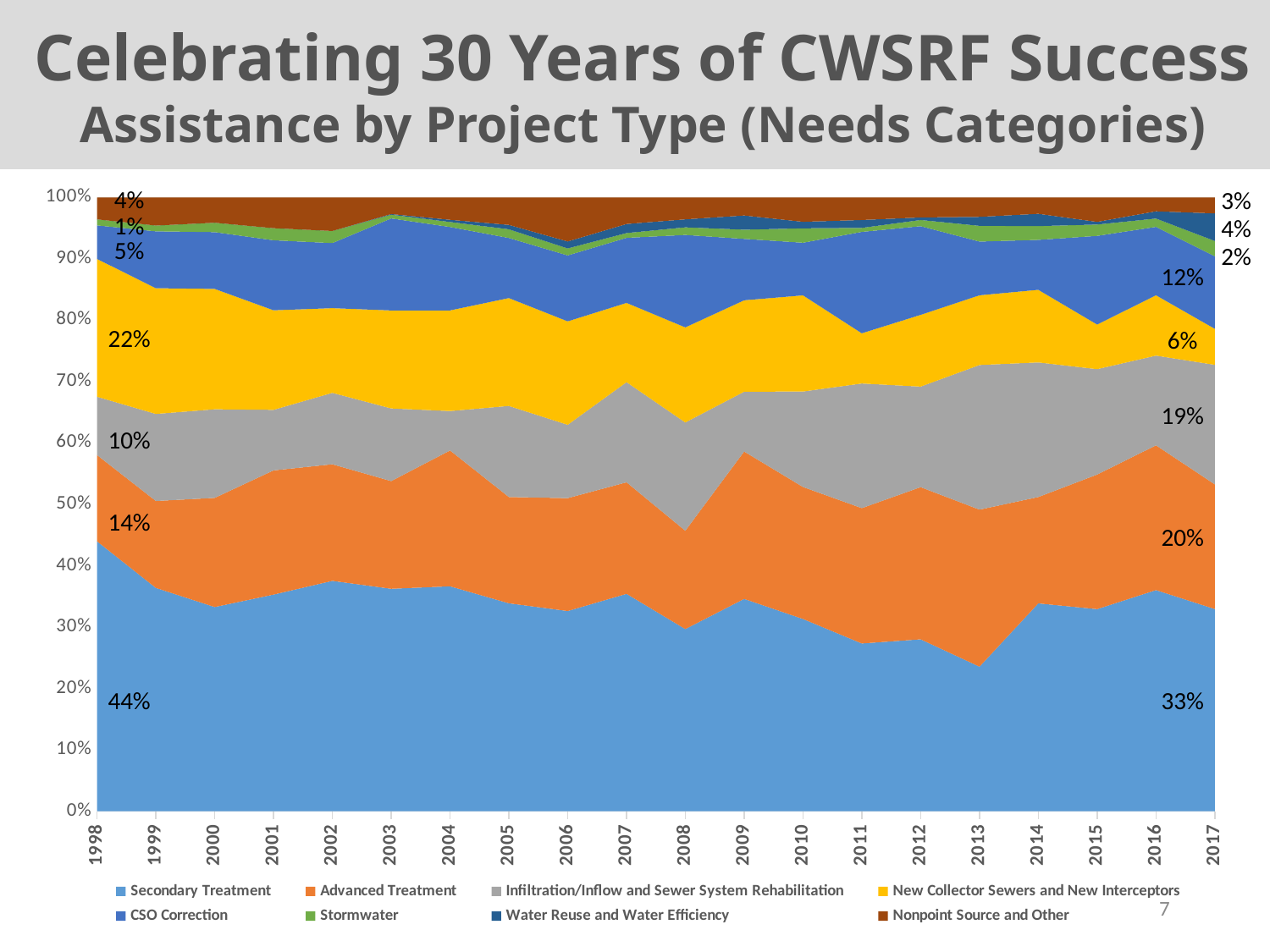
How many years are shown on the x axis? 20 By how many percentage points did the Secondary Treatment share fall from 1998 to 2017? 11 percentage points What kind of chart is shown on the slide? Stacked area chart What share did CSO Correction have in 2017? 12% What percentage of assistance went to Secondary Treatment in 2017? 33% What share did Infiltration/Inflow and Sewer System Rehabilitation have in 2017? 19% Was the Advanced Treatment share larger in 1998 or in 2017? 2017 What share did New Collector Sewers and New Interceptors have in 1998? 22% Which project type had the largest share of assistance in 1998? Secondary Treatment How many project types does the legend list? 8 Is the Secondary Treatment share in 2013 greater or less than 30%? less What percentage of assistance went to Secondary Treatment in 1998? 44%